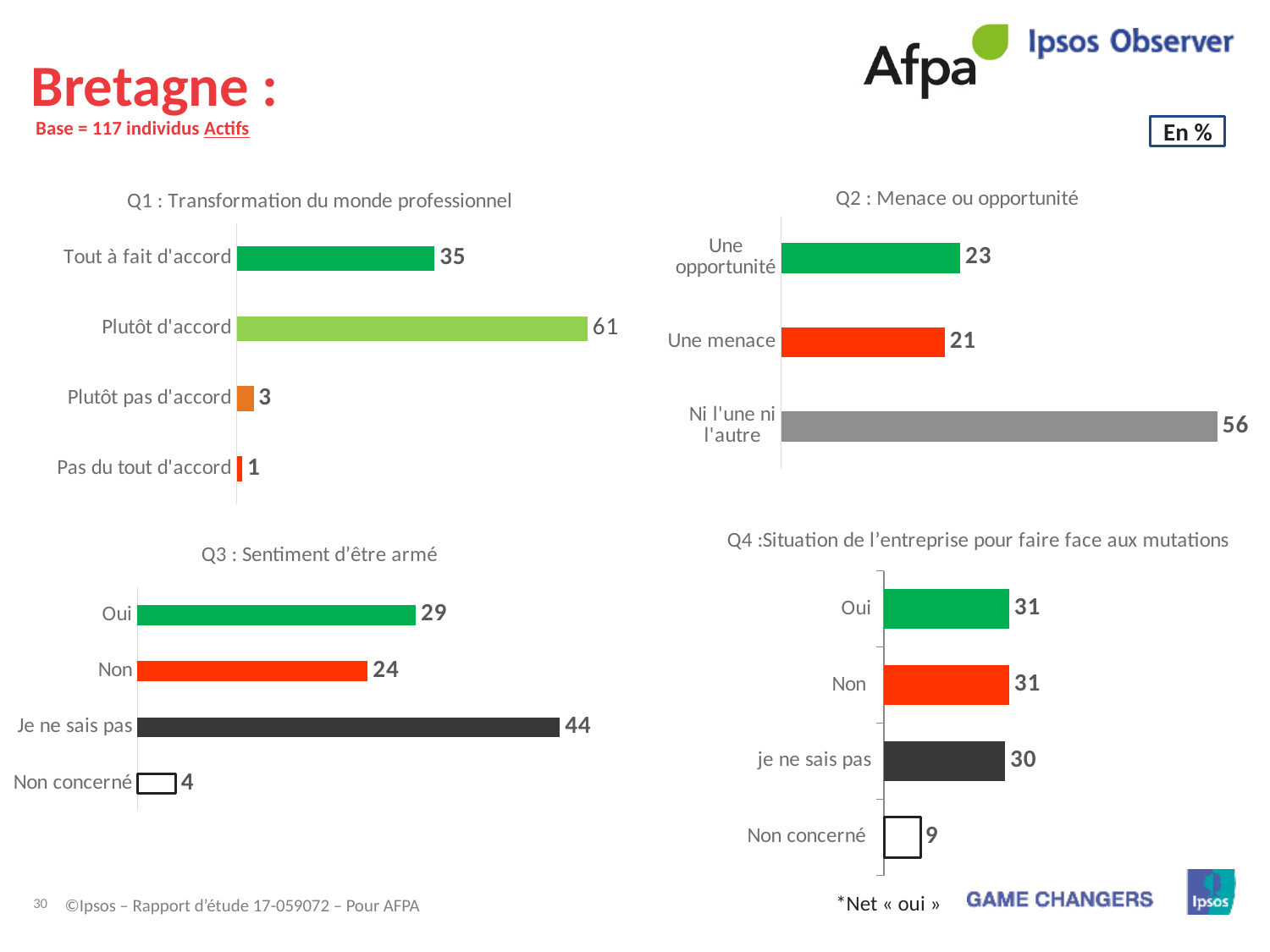
In the chart 'Q2 : Menace ou opportunité', how many categories are shown? 3 In the chart 'Q1 : Transformation du monde professionnel', what is the difference between 'Plutôt d'accord' and 'Tout à fait d'accord'? 26 In the chart 'Q4 : Situation de l'entreprise pour faire face aux mutations', how many categories are shown? 4 In the chart 'Q3 : Sentiment d'être armé', what is the value for 'Je ne sais pas'? 44 In the chart 'Q2 : Menace ou opportunité', which category has the highest value? Ni l'une ni l'autre In the chart 'Q1 : Transformation du monde professionnel', which category has the lowest value? Pas du tout d'accord In the chart 'Q3 : Sentiment d'être armé', which is larger, 'Oui' or 'Non'? Oui In the chart 'Q2 : Menace ou opportunité', what is the value for 'Une menace'? 21 What kind of chart is 'Q1 : Transformation du monde professionnel'? Bar chart In the chart 'Q3 : Sentiment d'être armé', what is the difference between 'Je ne sais pas' and 'Non concerné'? 40 In the chart 'Q4 : Situation de l'entreprise pour faire face aux mutations', what is the value for 'Non concerné'? 9 In the chart 'Q1 : Transformation du monde professionnel', what is the value for 'Plutôt d'accord'? 61